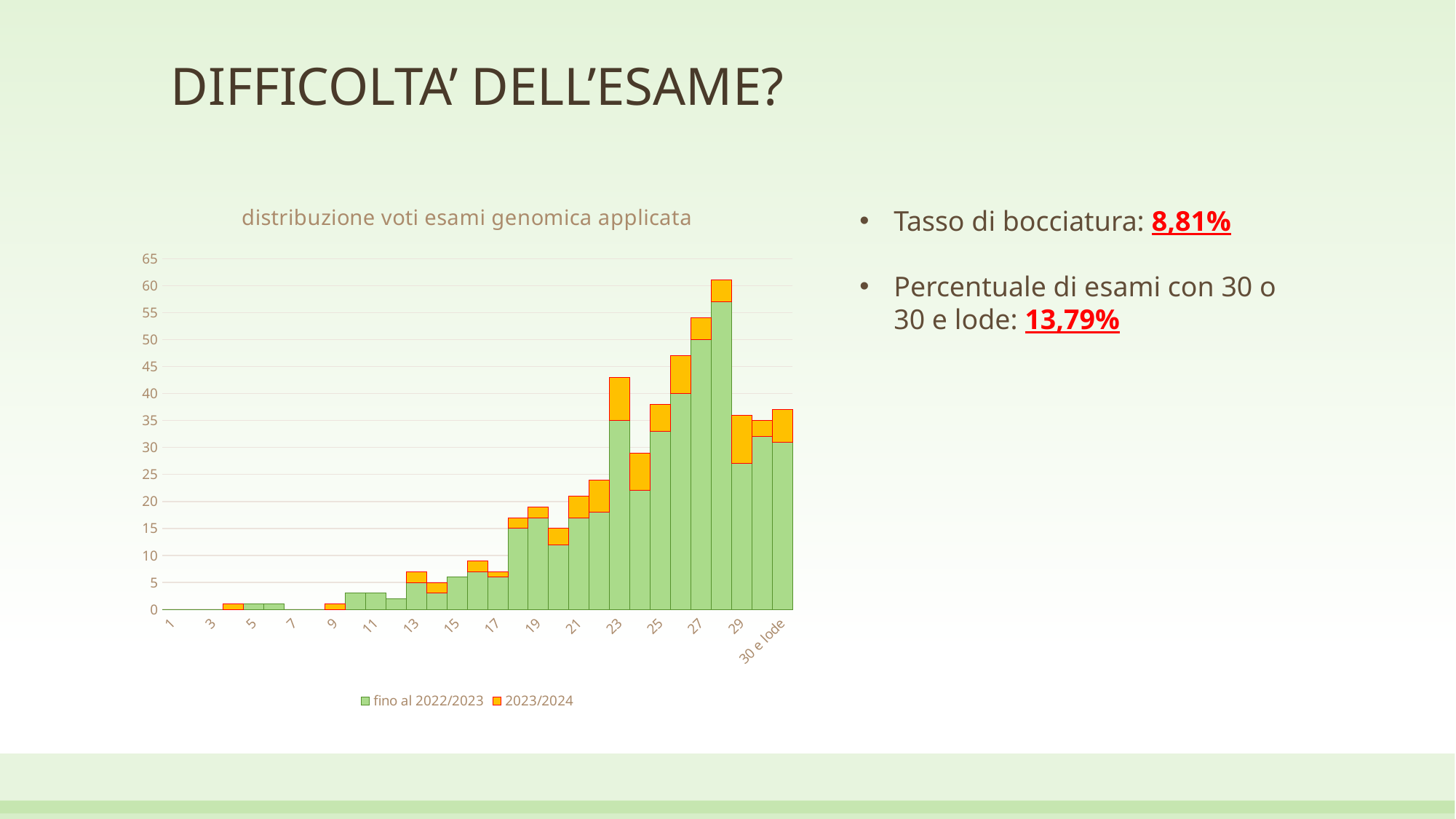
What is the title of the chart? distribuzione voti esami genomica applicata Which has a larger total value, category 27 or category 29? 27 Do the bar totals generally rise or fall from category 9 to category 27? rise Is the total value for category 13 greater or less than 10? less What kind of chart is shown on the slide? stacked bar chart Which series is shown in orange in the chart? 2023/2024 Is the total value for category 30 e lode greater or less than 35? greater Which has a larger total value, category 23 or category 25? 23 How many series does the legend of the chart list? 2 Is the total value of the tallest bar in the chart greater or less than 55? greater